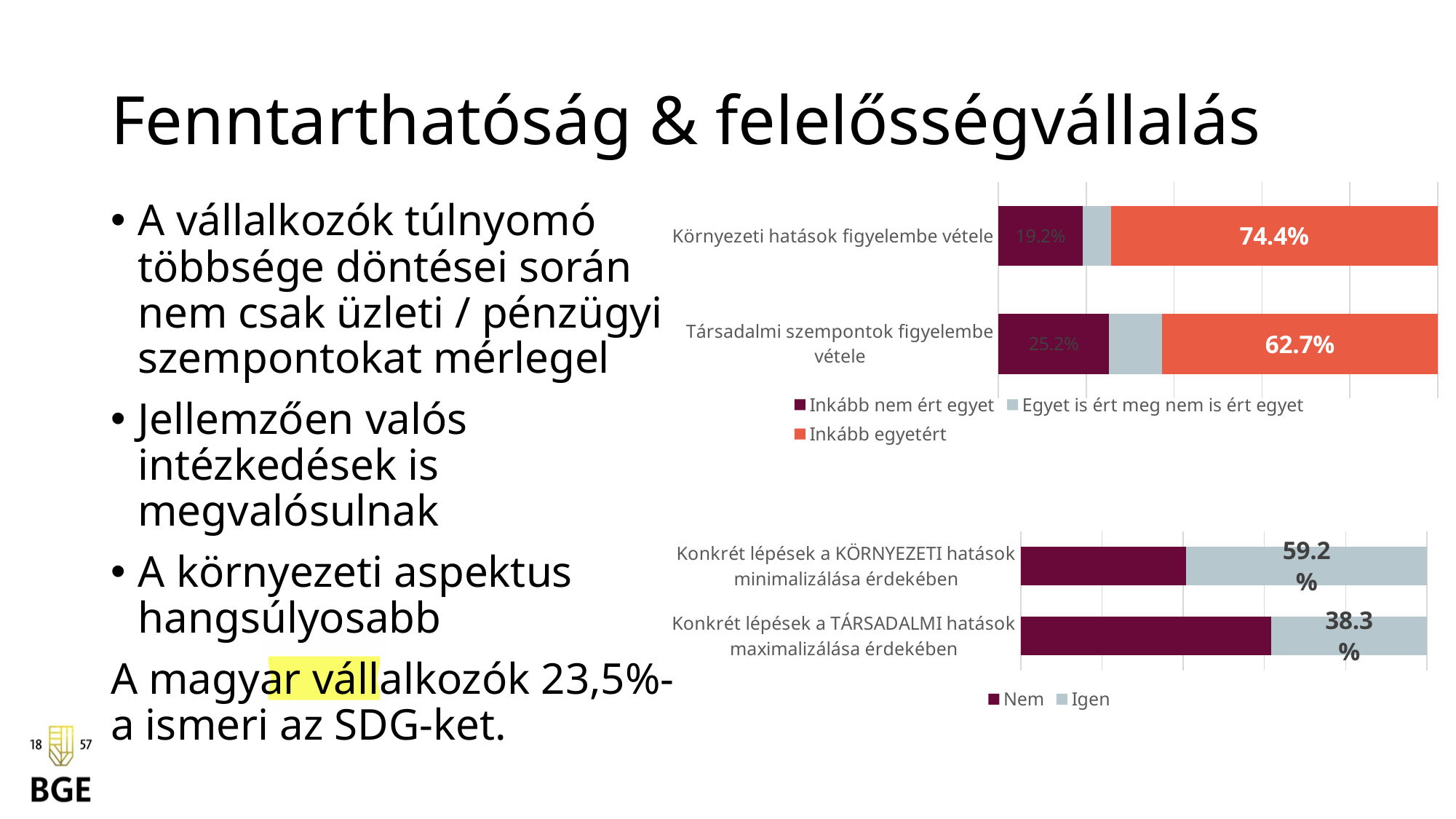
In the top chart, what is the 'Inkább egyetért' value for 'Társadalmi szempontok figyelembe vétele'? 62.7% In the top chart, what is the 'Inkább nem ért egyet' value for 'Társadalmi szempontok figyelembe vétele'? 25.2% In the bottom chart, what is the 'Igen' value for 'Konkrét lépések a TÁRSADALMI hatások maximalizálása érdekében'? 38.3% In the bottom chart, what is the 'Igen' value for 'Konkrét lépések a KÖRNYEZETI hatások minimalizálása érdekében'? 59.2% In the top chart, which category has the higher 'Inkább egyetért' share? Környezeti hatások figyelembe vétele How many series does the legend of the top chart list? 3 In the top chart, what is the difference between the 'Inkább egyetért' values of the two categories? 11.7 percentage points In the top chart, what is the 'Inkább nem ért egyet' value for 'Környezeti hatások figyelembe vétele'? 19.2% In the top chart, what percentage of respondents chose 'Inkább egyetért' for 'Környezeti hatások figyelembe vétele'? 74.4% What kind of chart is the bottom chart? Stacked bar chart How many series does the legend of the bottom chart list? 2 In the bottom chart, what is the difference between the two 'Igen' values? 20.9 percentage points